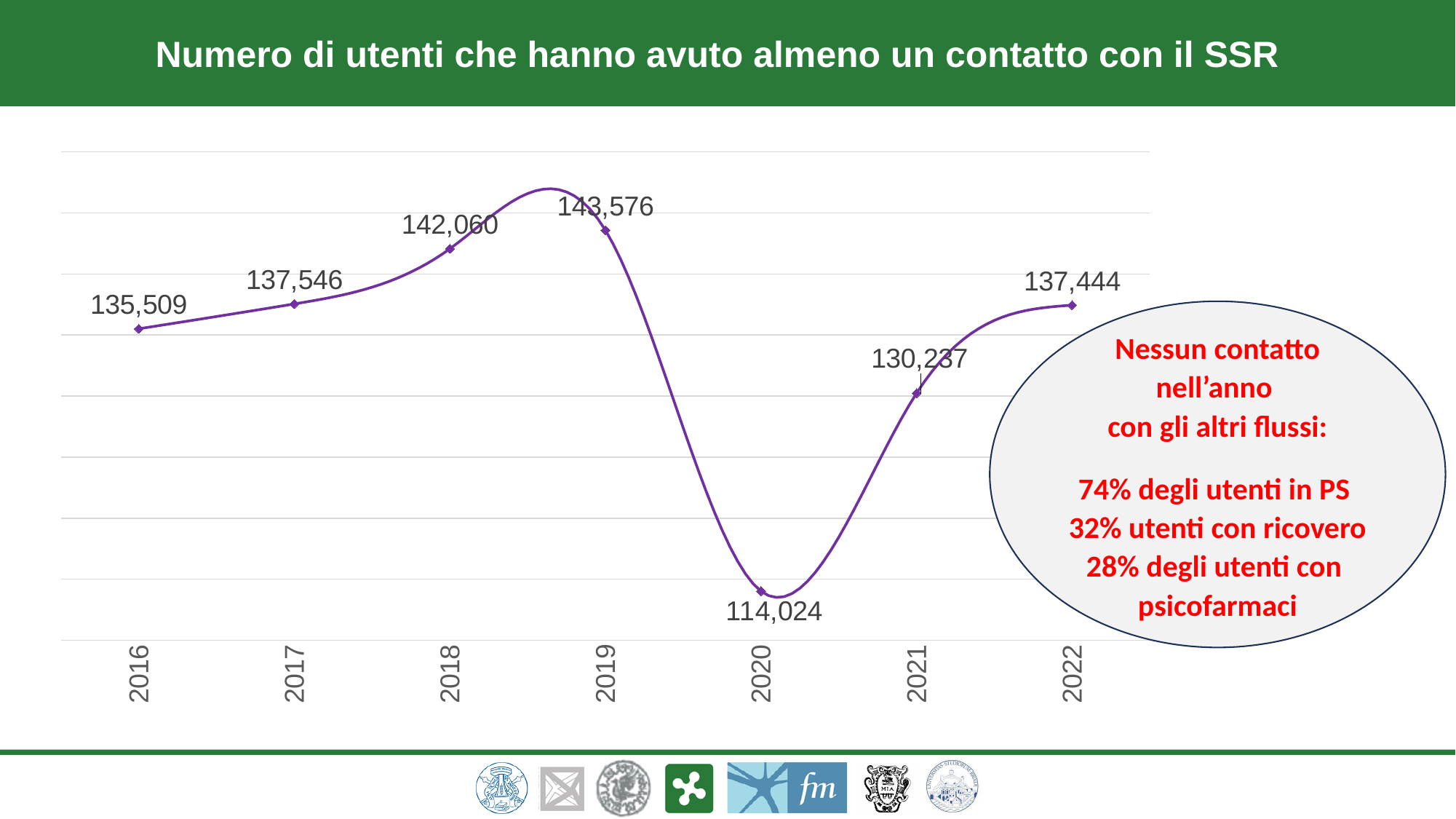
What is the difference between the values for 2019 and 2020? 29,552 Which year has the highest value? 2019 What is the value for 2019? 143,576 Do the values rise or fall from 2016 to 2019? Rise What kind of chart is shown? Line chart What is the value for 2022? 137,444 How many years are plotted on the chart? 7 Which is larger, the value for 2021 or the value for 2022? 2022 Which year has the lowest value? 2020 What is the value for 2020? 114,024 What is the value for 2016? 135,509 What is the difference between the values for 2018 and 2017? 4,514